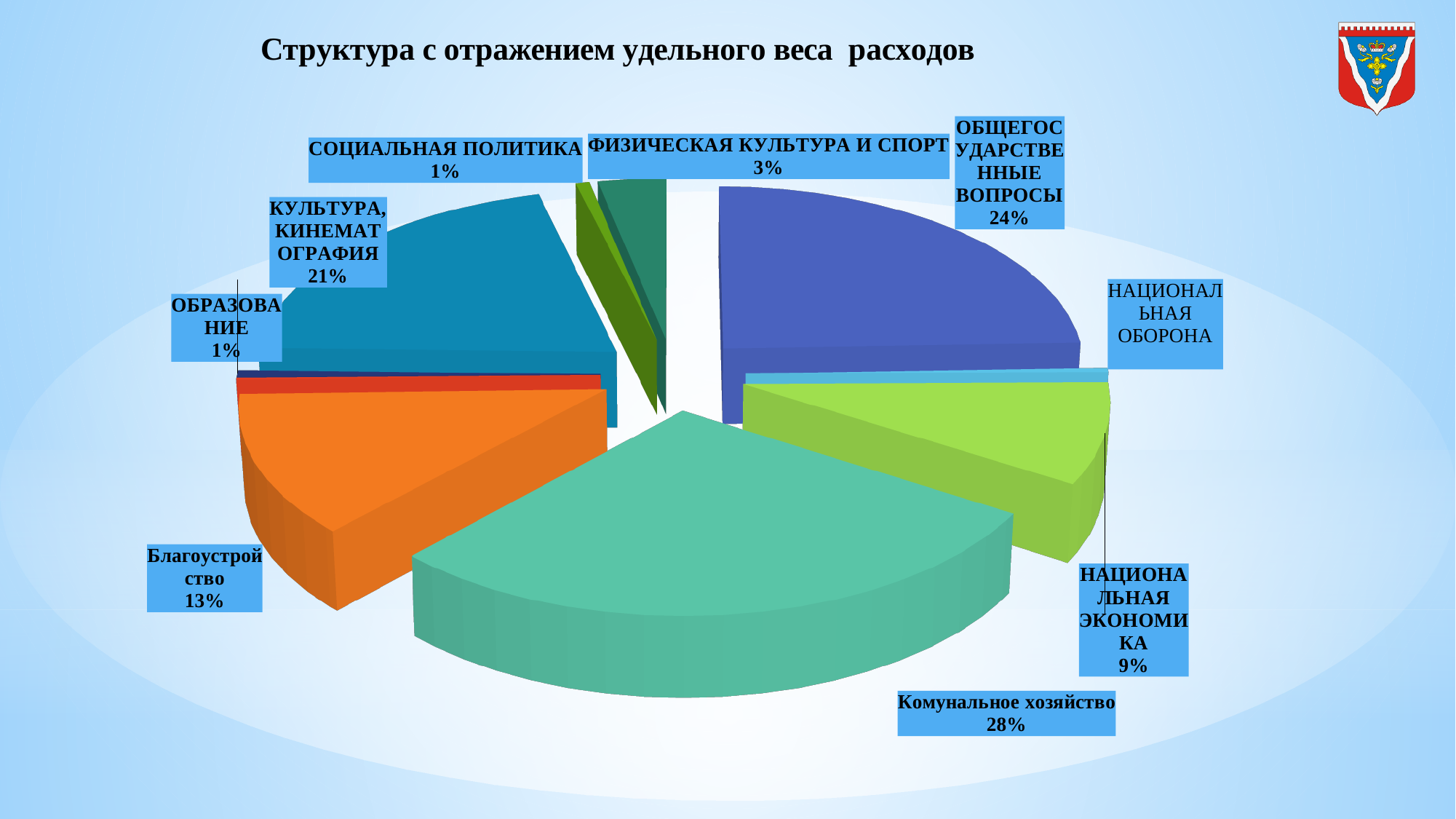
What is the title of the slide? Структура с отражением удельного веса расходов What is the value shown for Общегосударственные вопросы? 24% Which is larger, the share for Благоустройство or the share for Национальная экономика? Благоустройство Which category has the largest share of the pie? Комунальное хозяйство What is the value for Благоустройство? 13% What percentage is shown for Культура, кинематография? 21% What share of expenses does Комунальное хозяйство account for? 28% What percentage is shown for Национальная экономика? 9% How many categories are labelled on the pie chart? 9 What kind of chart is shown on the slide? Pie chart What is the difference between the shares of Комунальное хозяйство and Общегосударственные вопросы? 4% What is the value for Физическая культура и спорт? 3%